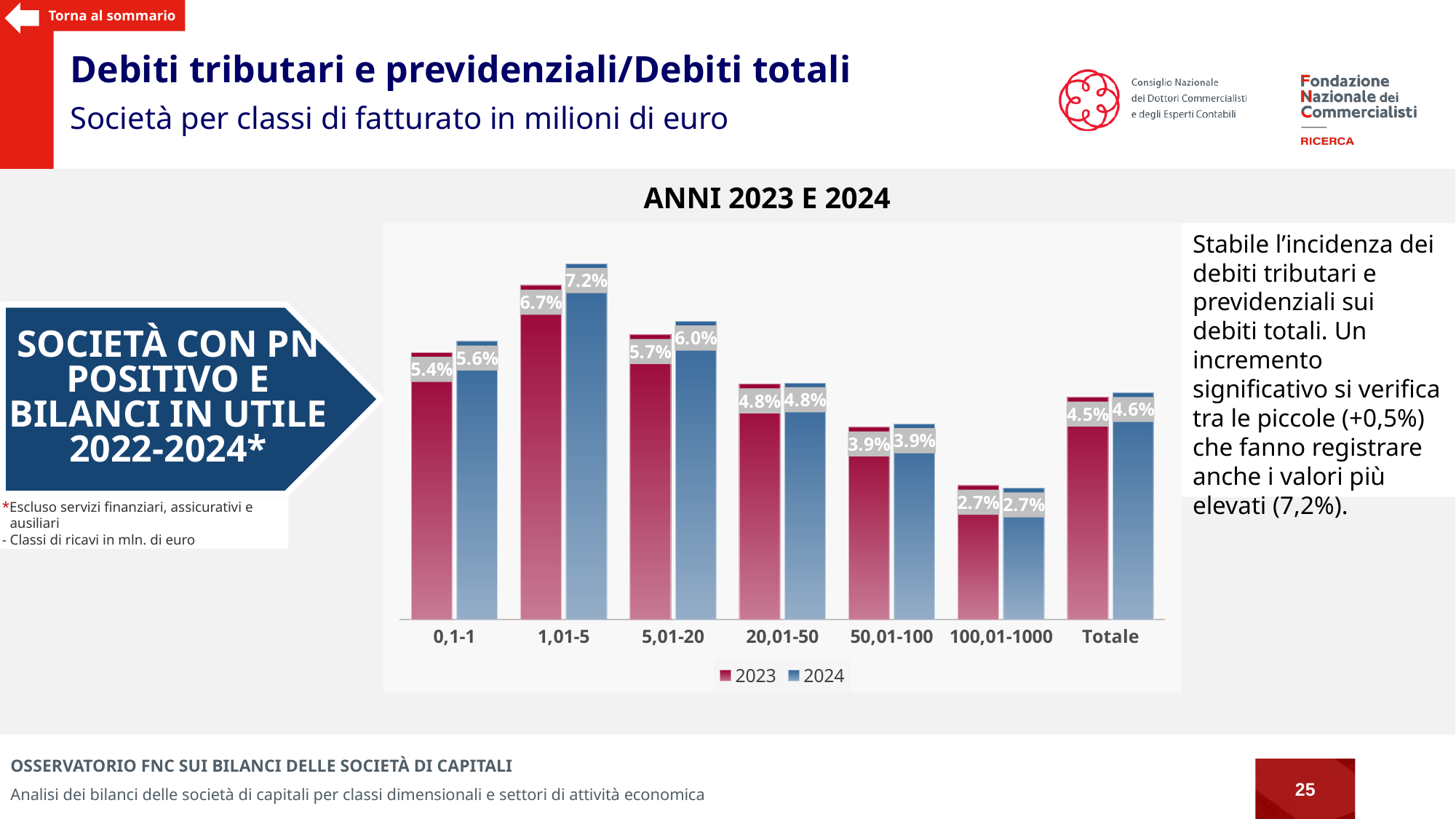
What kind of chart is shown on the slide? Bar chart From the 1,01-5 category to the 100,01-1000 category, do the 2023 values rise or fall? Fall What is the 2024 value for Totale? 4.6% Which category has the lowest 2024 value? 100,01-1000 What is the value for 2024 in the 1,01-5 category? 7.2% Which is larger in the 0,1-1 category, the 2023 value or the 2024 value? 2024 How many categories are shown on the x axis? 7 What is the value for 2023 in the 5,01-20 category? 5.7% What is the title shown above the chart? ANNI 2023 E 2024 How many series does the legend list? 2 Which category has the highest 2023 value? 1,01-5 What is the difference between the 2024 and 2023 values in the 1,01-5 category? 0.5%